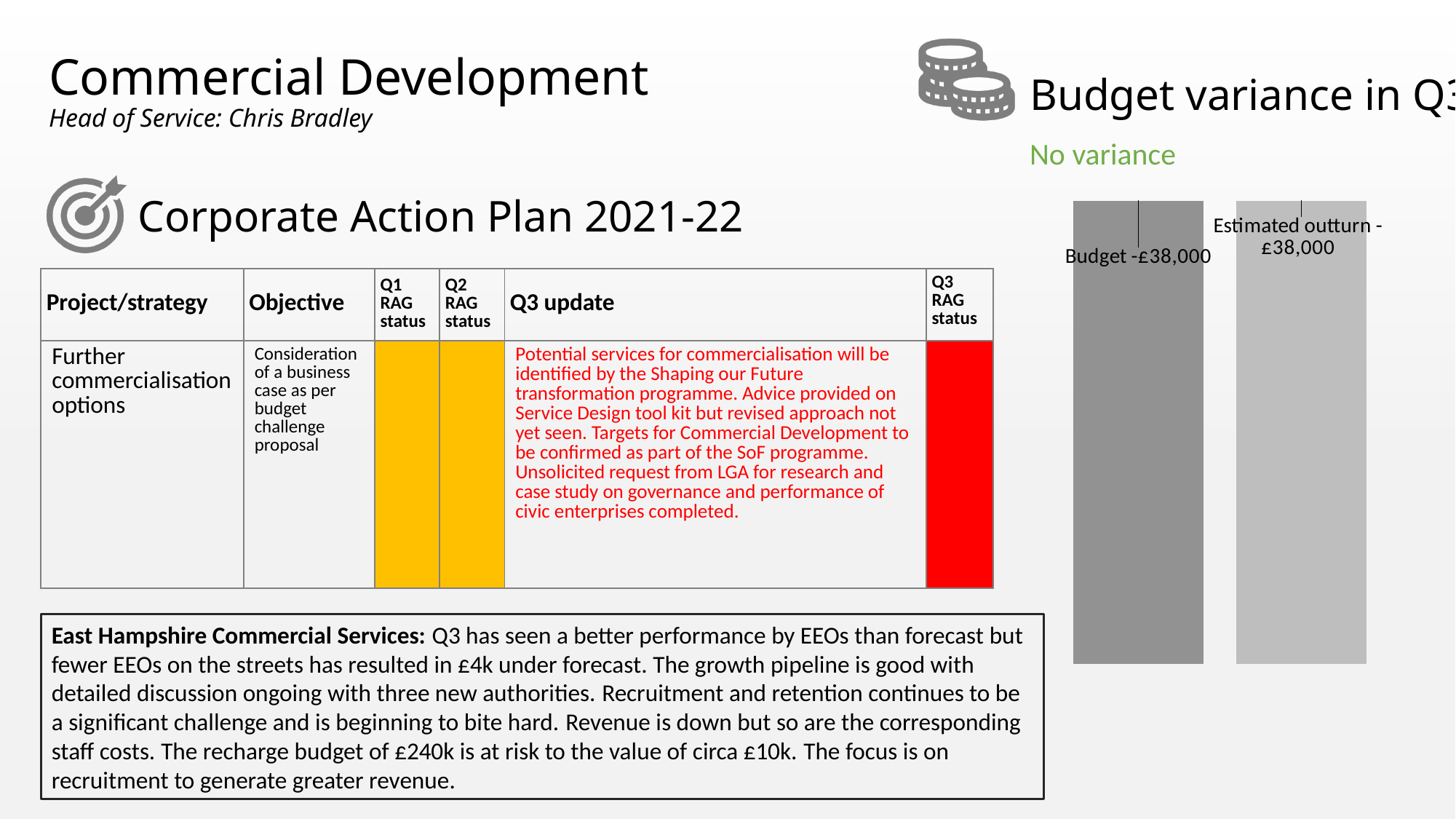
What are the two categories shown in the Budget variance in Q3 chart? Budget and Estimated outturn What is the difference between the Budget and Estimated outturn values in the Budget variance in Q3 chart? £0 What is the value of the Budget bar in the Budget variance in Q3 chart? £38,000 What does the green text above the Budget variance in Q3 chart say? No variance What is the value of the Estimated outturn bar in the Budget variance in Q3 chart? £38,000 What kind of chart is the Budget variance in Q3 chart? Bar chart How many bars are plotted in the Budget variance in Q3 chart? 2 Are the Budget and Estimated outturn bars in the Budget variance in Q3 chart the same height or different heights? The same height